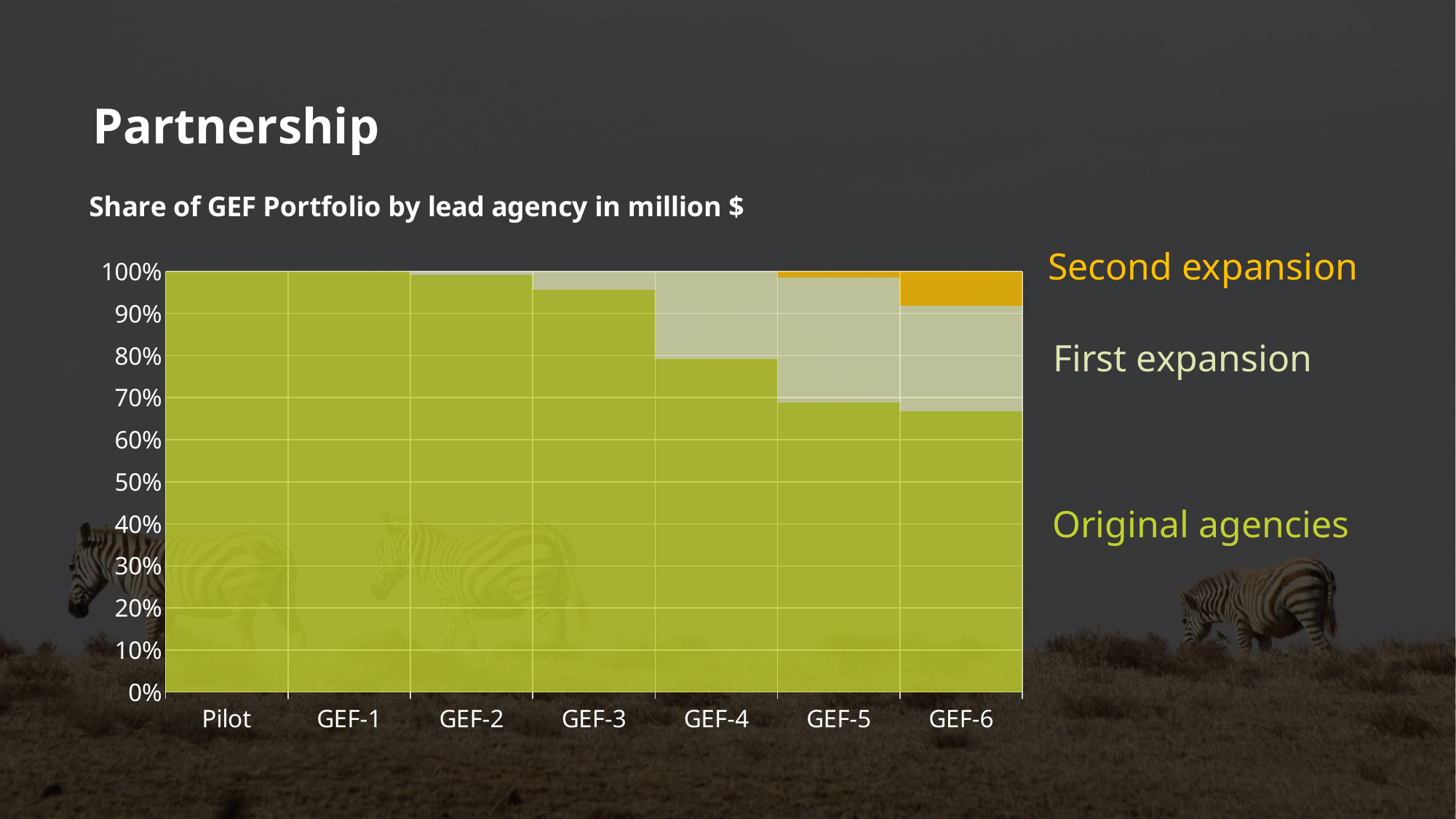
What is the title of the chart? Share of GEF Portfolio by lead agency in million $ What is the share of Original agencies in the Pilot period? 100% Is the share of Original agencies larger in GEF-3 or in GEF-5? GEF-3 How many series are labelled on the chart? 3 Is the share of Original agencies in GEF-4 greater or less than 70%? greater Is the share of Original agencies in GEF-3 greater or less than 90%? greater How many periods are shown along the x axis of the chart? 7 Does the share of Original agencies rise or fall from Pilot to GEF-6? Fall What kind of chart is shown on the slide? Stacked bar chart In which period is the share of Second expansion agencies the largest? GEF-6 Which series is shown in orange at the top of the chart? Second expansion Is the share of Original agencies in GEF-5 greater or less than 80%? less